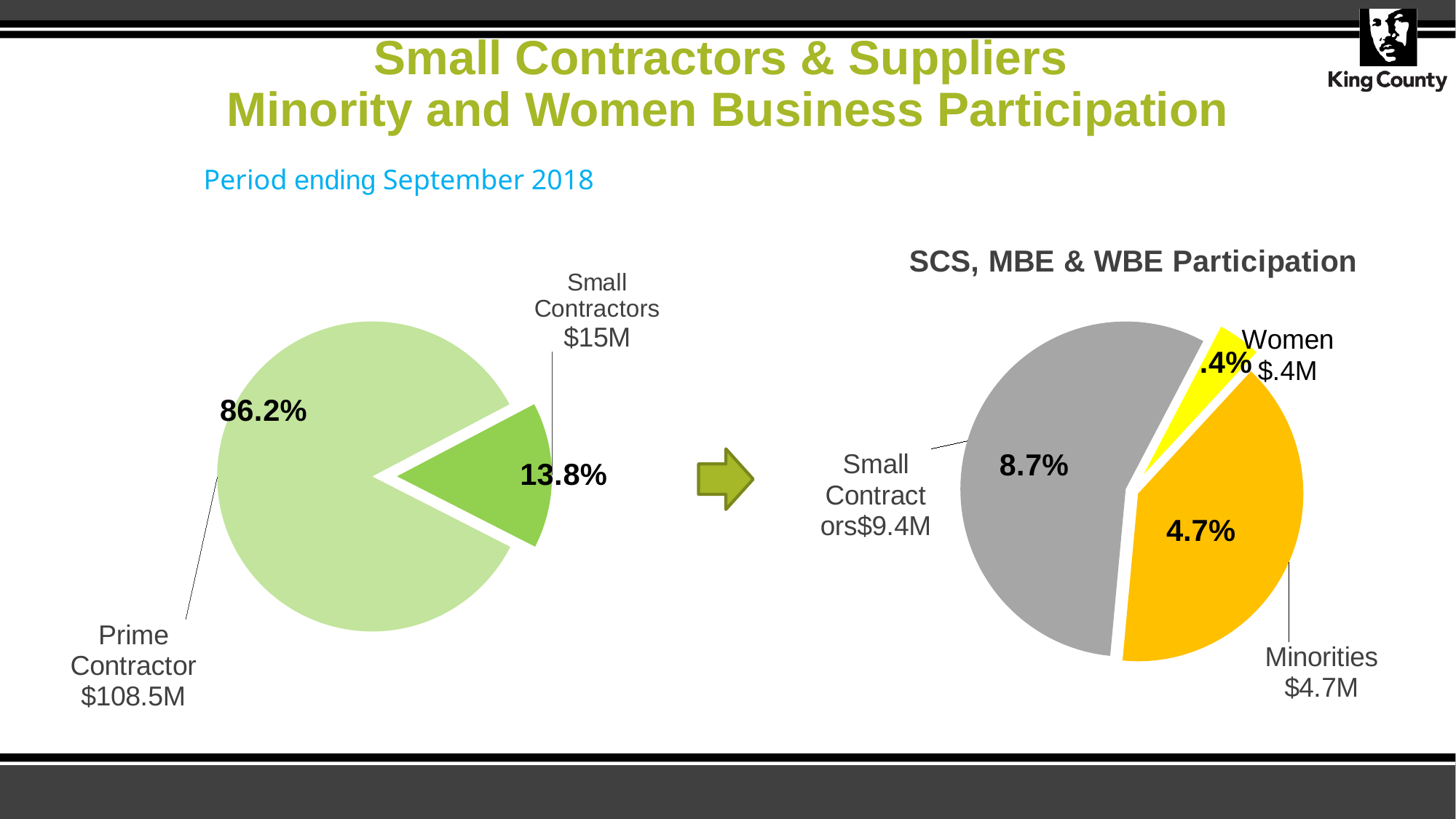
In the left pie chart, what dollar amount is shown for Prime Contractor? $108.5M In the 'SCS, MBE & WBE Participation' chart, what percentage is labelled on the Small Contractors slice? 8.7% In the left pie chart, which slice is larger, Prime Contractor or Small Contractors? Prime Contractor In the left pie chart, what dollar amount is shown for Small Contractors? $15M In the 'SCS, MBE & WBE Participation' chart, what dollar amount is shown for Minorities? $4.7M What is the title of the right-hand pie chart? SCS, MBE & WBE Participation In the 'SCS, MBE & WBE Participation' chart, which category has the smallest slice? Women How many slices does the 'SCS, MBE & WBE Participation' pie chart have? 3 What kind of chart is the left chart on the slide? pie chart In the 'SCS, MBE & WBE Participation' chart, which category has the largest slice? Small Contractors In the 'SCS, MBE & WBE Participation' chart, what is the difference in dollars between Minorities and Women? $4.3M In the left pie chart, what percentage share is labelled for Prime Contractor? 86.2%